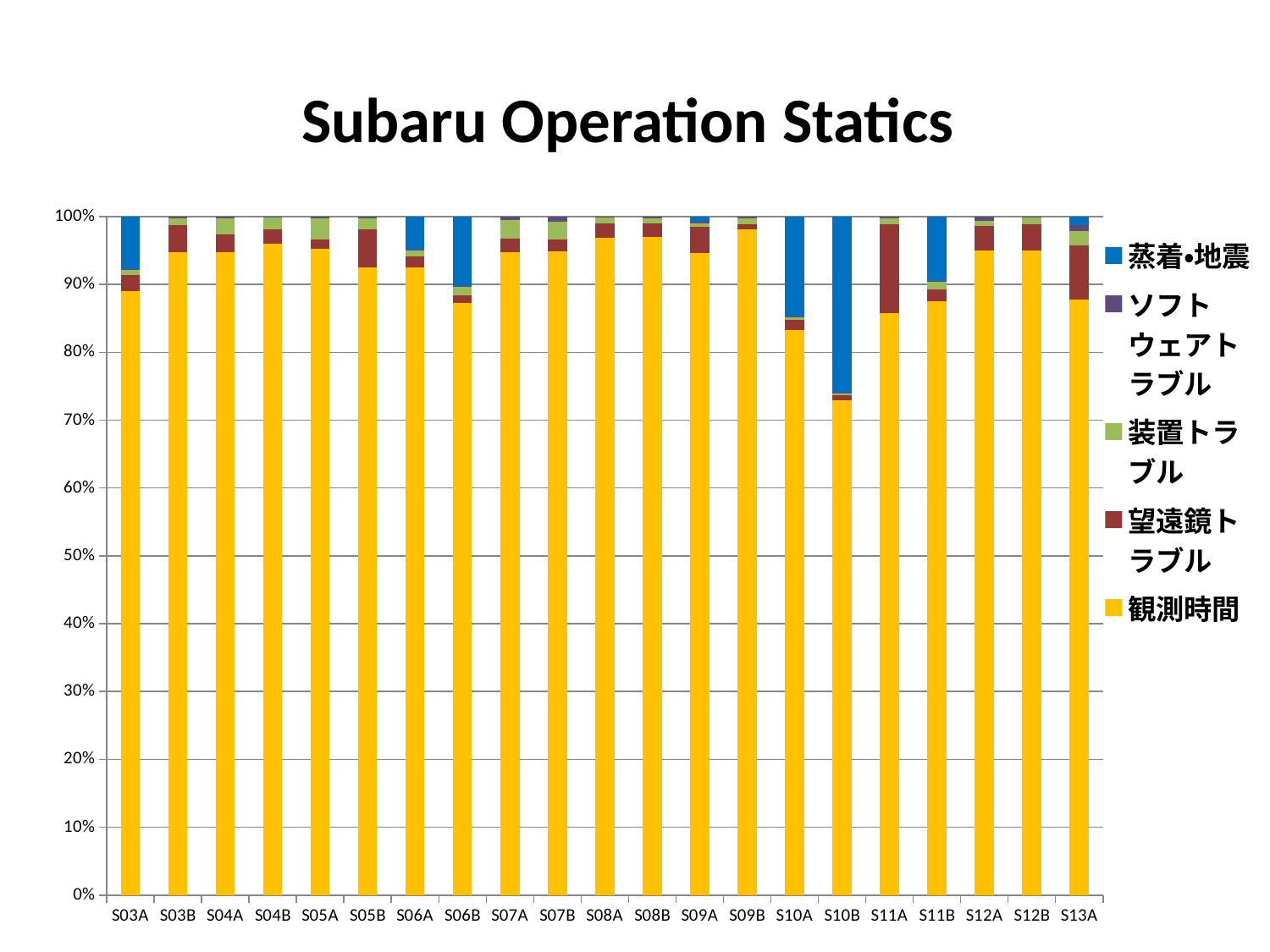
How many categories (semesters) are shown on the x axis? 21 Which colour represents 観測時間 in the chart? Yellow What kind of chart is shown on the slide? Stacked bar chart Is the value for 観測時間 in S09B greater or less than 90%? greater Which has the larger 観測時間 value, S11A or S10B? S11A How many series does the legend list? 5 Is the value for 観測時間 in S10A greater or less than 90%? less What is the total of the stacked bar for S05A? 100% Is the value for 観測時間 in S10B greater or less than 80%? less Which has the larger 観測時間 value, S10A or S10B? S10A What is the title of the chart? Subaru Operation Statics Which category has the lowest value for 観測時間? S10B